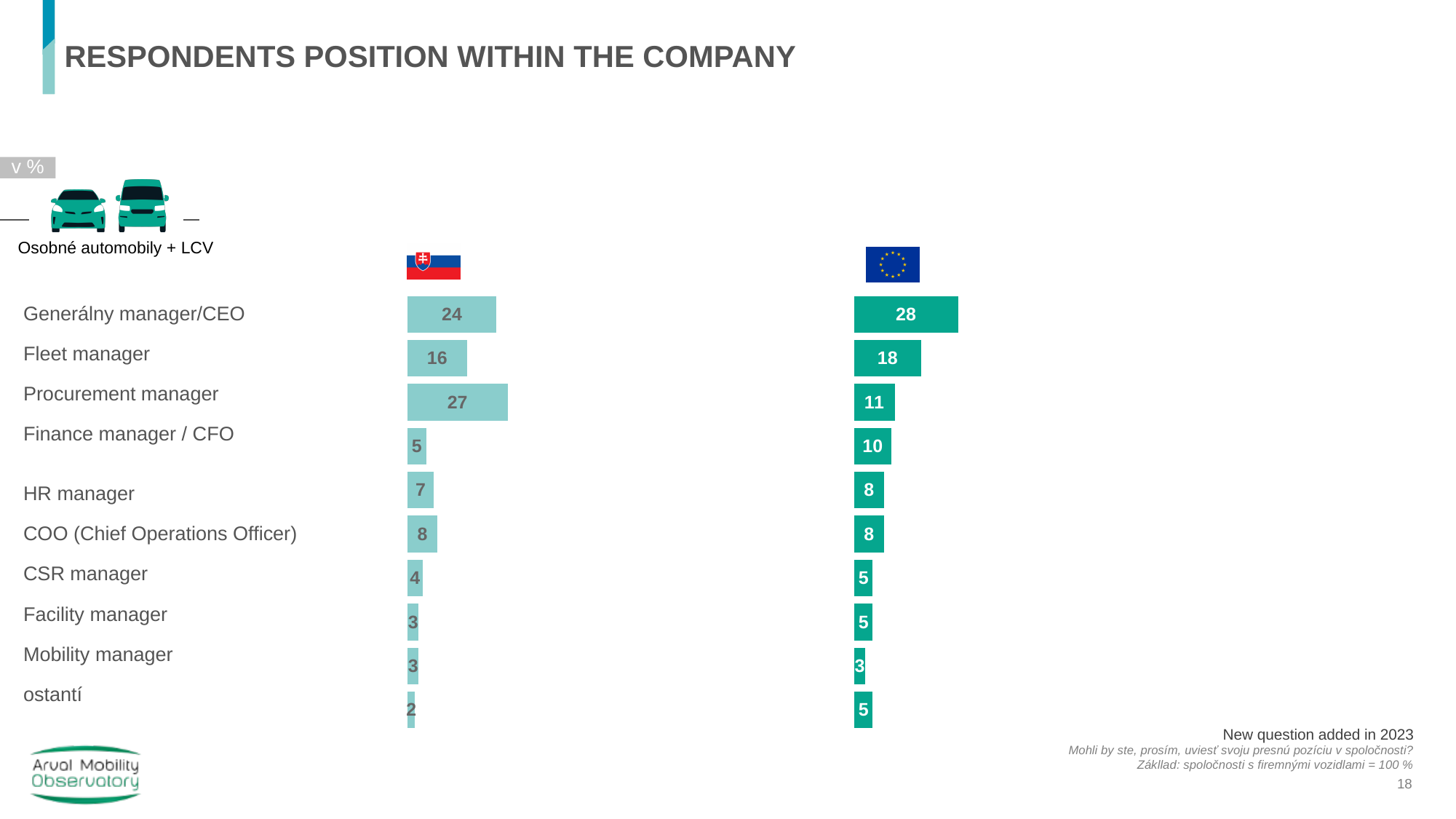
How many positions (categories) are listed in each chart? 10 In the Slovakia chart, which position has the highest value? Procurement manager What is the difference between the Slovakia value and the EU value for Procurement manager? 16 What is the title of the slide? RESPONDENTS POSITION WITHIN THE COMPANY In the Slovakia chart (left, with the Slovak flag), what is the value for Procurement manager? 27 In the Slovakia chart, which position has the lowest value? ostantí For Finance manager / CFO, which chart shows the larger value, Slovakia or EU? EU In the EU chart, which position has the highest value? Generálny manager/CEO What type of chart is used on this slide? Bar chart In the EU chart, which position has the lowest value? Mobility manager In the EU chart (right, with the EU flag), what is the value for Fleet manager? 18 What is the difference between the EU value and the Slovakia value for Generálny manager/CEO? 4